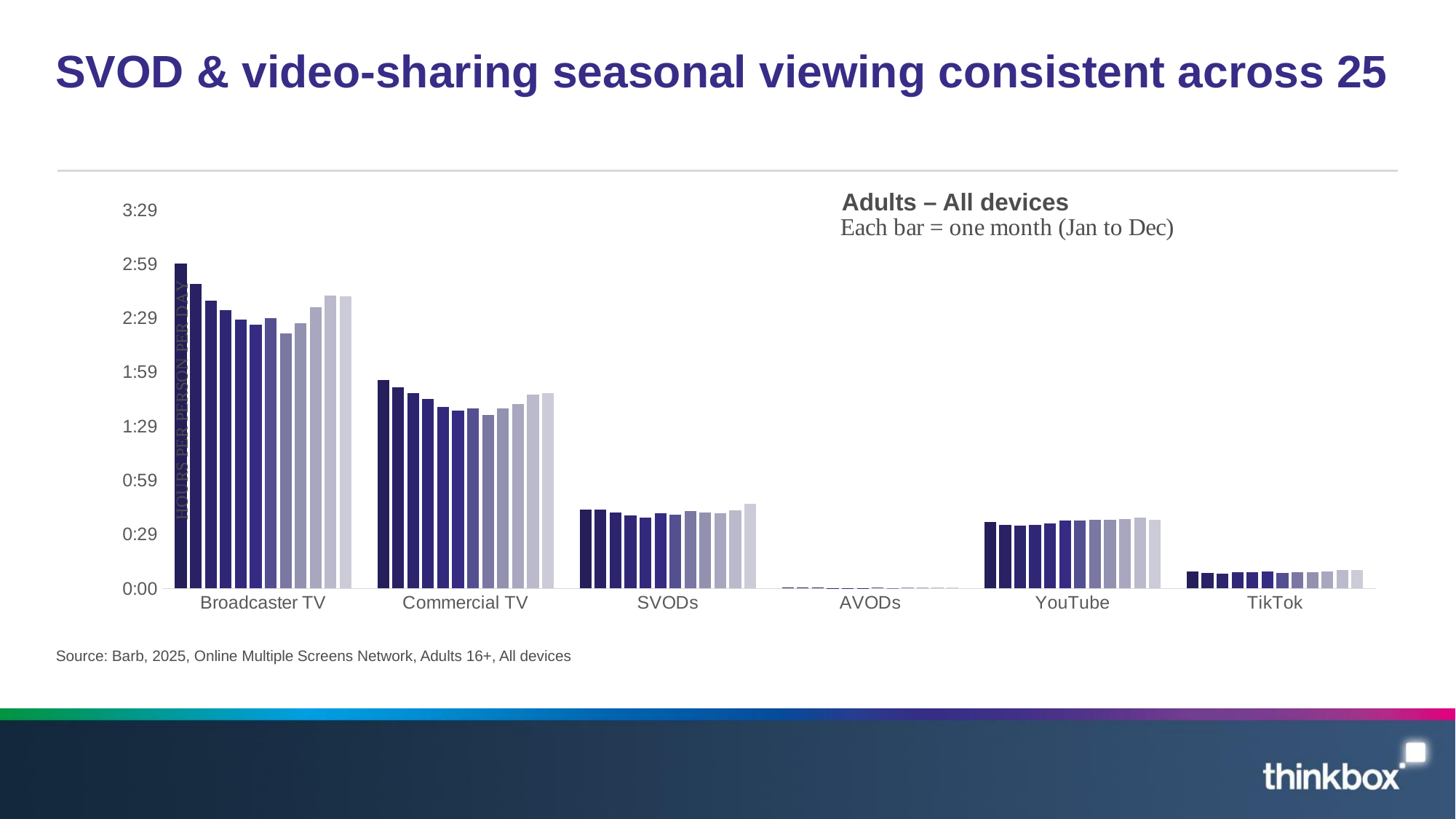
Which category has higher values, YouTube or TikTok? YouTube How many bars are plotted for each category on the chart? 12 What kind of chart is shown on the slide? Bar chart Which category has higher values, Broadcaster TV or Commercial TV? Broadcaster TV Is the value for the first (January) bar of Broadcaster TV greater or less than 2:29? greater Which category has the highest viewing values on the chart? Broadcaster TV What does the vertical axis of the chart measure, according to its axis title? Hours per person per day Are the values for the Commercial TV bars greater or less than 1:29? greater How many categories are shown along the x axis of the chart? 6 Which category has the lowest viewing values on the chart? AVODs Are the values for the TikTok bars greater or less than 0:29? less